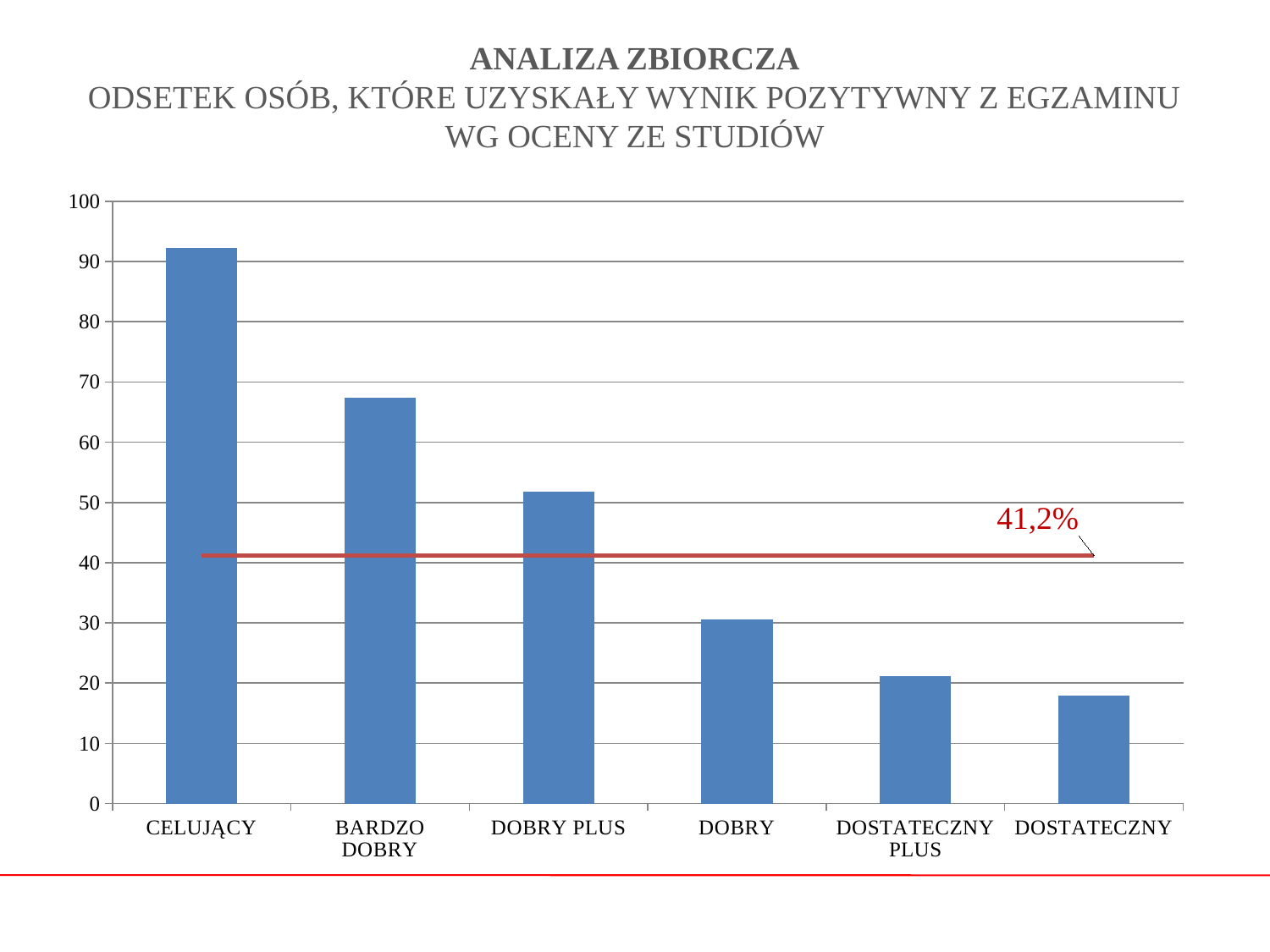
What value is labelled on the red horizontal line drawn across the chart? 41,2% Is the value for DOBRY greater or less than 40? less Is the value for DOBRY PLUS greater or less than 50? greater Is the value for CELUJĄCY greater or less than 90? greater How many grade categories are shown on the x axis? 6 Which is larger, the value for DOBRY or the value for DOSTATECZNY PLUS? DOBRY Which grade category has the highest bar? CELUJĄCY What kind of chart is shown on the slide? bar chart Which grade category has the lowest bar? DOSTATECZNY Do the bar values rise or fall from left to right along the x axis? fall Which is larger, the value for BARDZO DOBRY or the value for DOBRY PLUS? BARDZO DOBRY